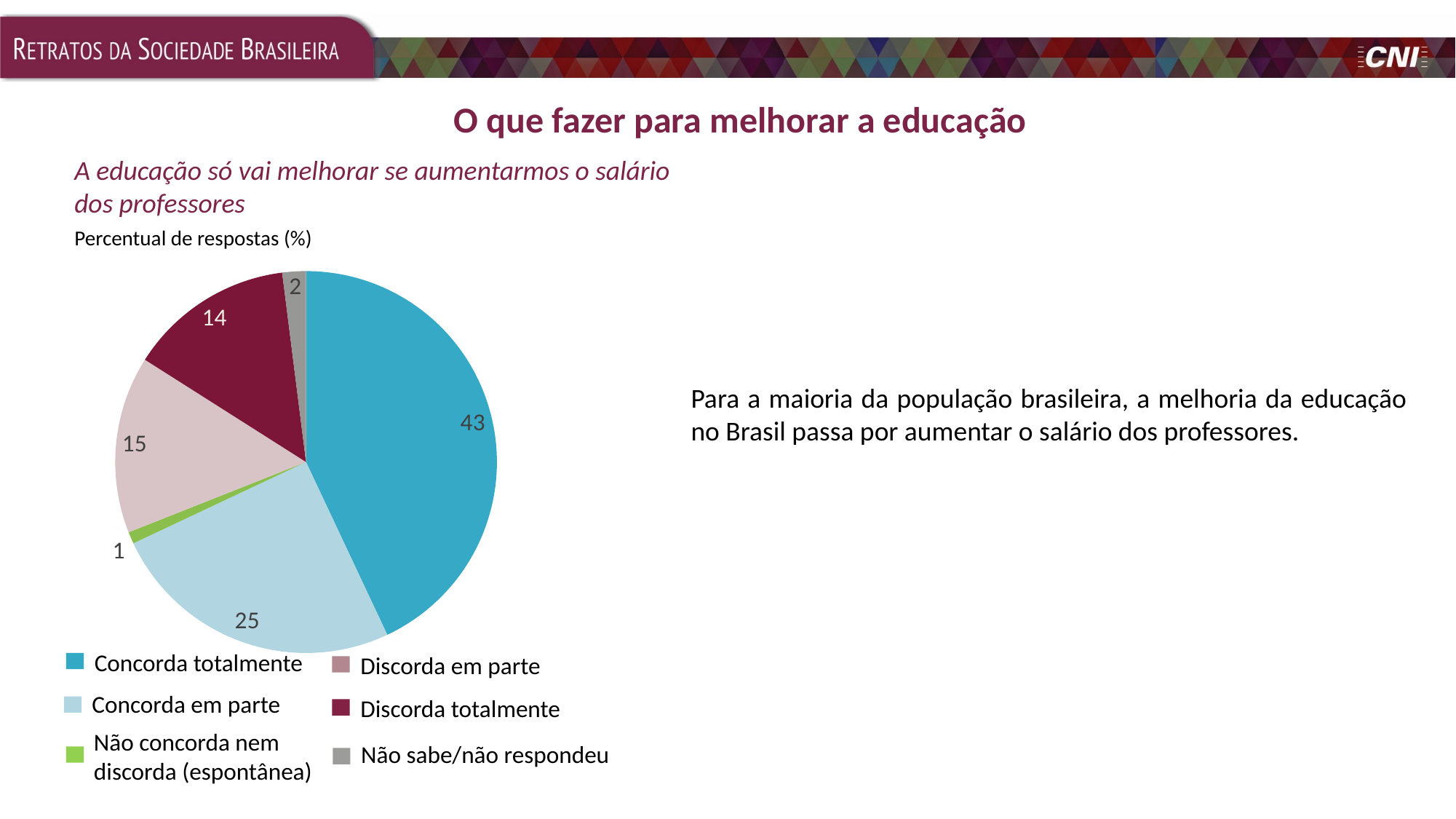
Which response category has the smallest share of the pie? Não concorda nem discorda (espontânea) Which is larger: the share for "Discorda em parte" or for "Discorda totalmente"? Discorda em parte What percentage of respondents answered "Não sabe/não respondeu"? 2 What percentage of respondents answered "Discorda totalmente"? 14 What percentage of respondents answered "Concorda totalmente"? 43 How many response categories does the legend list? 6 What percentage of respondents answered "Concorda em parte"? 25 What type of chart is shown on the slide? pie chart What is the difference in percentage points between "Concorda totalmente" and "Concorda em parte"? 18 Which response category has the largest share of the pie? Concorda totalmente What percentage of respondents answered "Discorda em parte"? 15 What is the subtitle of the chart describing the unit of the values? Percentual de respostas (%)